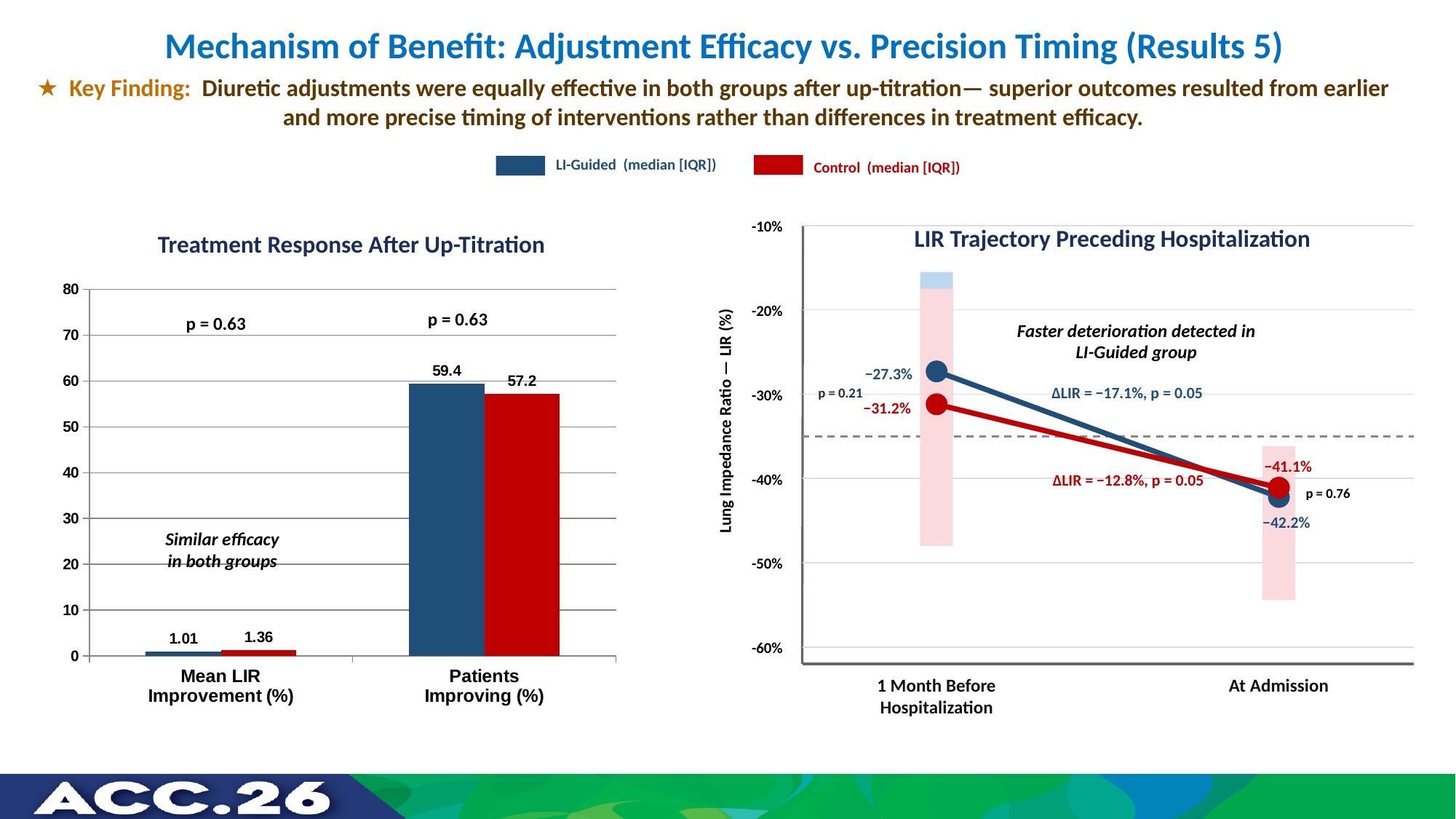
In the 'Treatment Response After Up-Titration' chart, what is the value for Control in the 'Mean LIR Improvement (%)' category? 1.36 In the 'LIR Trajectory Preceding Hospitalization' chart, what is the LI-Guided value at '1 Month Before Hospitalization'? −27.3% How many series does the legend list? 2 In the 'LIR Trajectory Preceding Hospitalization' chart, do the LIR values rise or fall from '1 Month Before Hospitalization' to 'At Admission'? Fall In the 'Treatment Response After Up-Titration' chart, what is the value for LI-Guided in the 'Patients Improving (%)' category? 59.4 In the 'LIR Trajectory Preceding Hospitalization' chart, what is the Control value at 'At Admission'? −41.1% What colour represents the Control group in the charts? Red In the 'Treatment Response After Up-Titration' chart, how many categories are shown on the x axis? 2 What kind of chart is 'Treatment Response After Up-Titration'? Bar chart In the 'Treatment Response After Up-Titration' chart, which group has the larger value for 'Mean LIR Improvement (%)'? Control In the 'LIR Trajectory Preceding Hospitalization' chart, what is the ΔLIR for the LI-Guided group? −17.1% In the 'Treatment Response After Up-Titration' chart, what is the difference between the LI-Guided and Control values for 'Patients Improving (%)'? 2.2